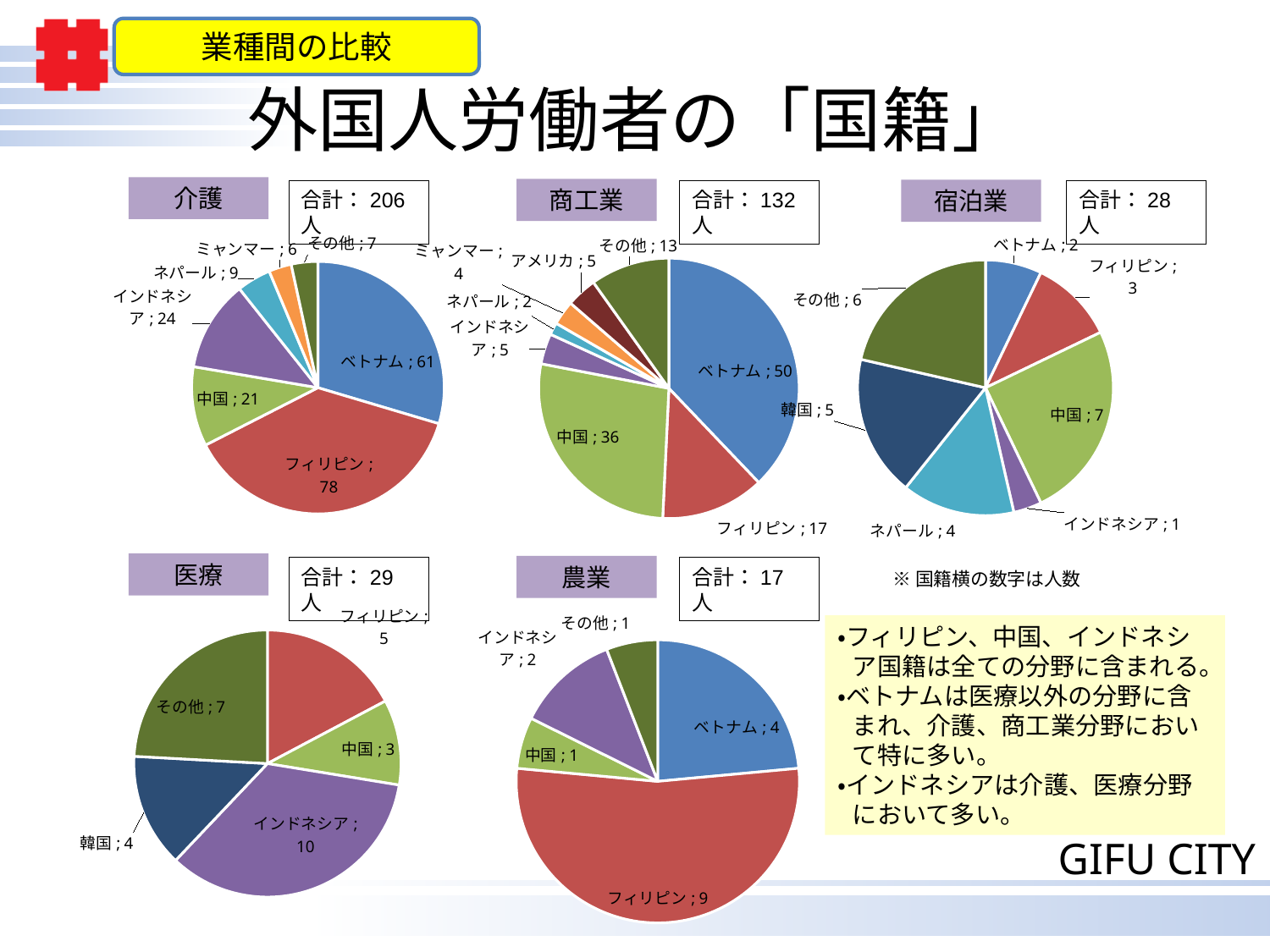
In the 介護 pie chart, what is the difference between the フィリピン and ベトナム values? 17 In the 介護 pie chart, which nationality has the largest number of workers? フィリピン What is the total (合計) shown for the 介護 chart? 206人 How many slices does the 医療 pie chart have? 5 In the 宿泊業 pie chart, how many workers are from 中国? 7 In the 介護 pie chart, how many workers are from フィリピン? 78 In the 商工業 pie chart, how many workers are from 中国? 36 In the 医療 pie chart, how many workers are from 韓国? 4 What type of chart is used on this slide? Pie chart In the 農業 pie chart, which is larger, ベトナム or インドネシア? ベトナム In the 医療 pie chart, which nationality has the largest number of workers? インドネシア In the 商工業 pie chart, which nationality has the largest slice? ベトナム